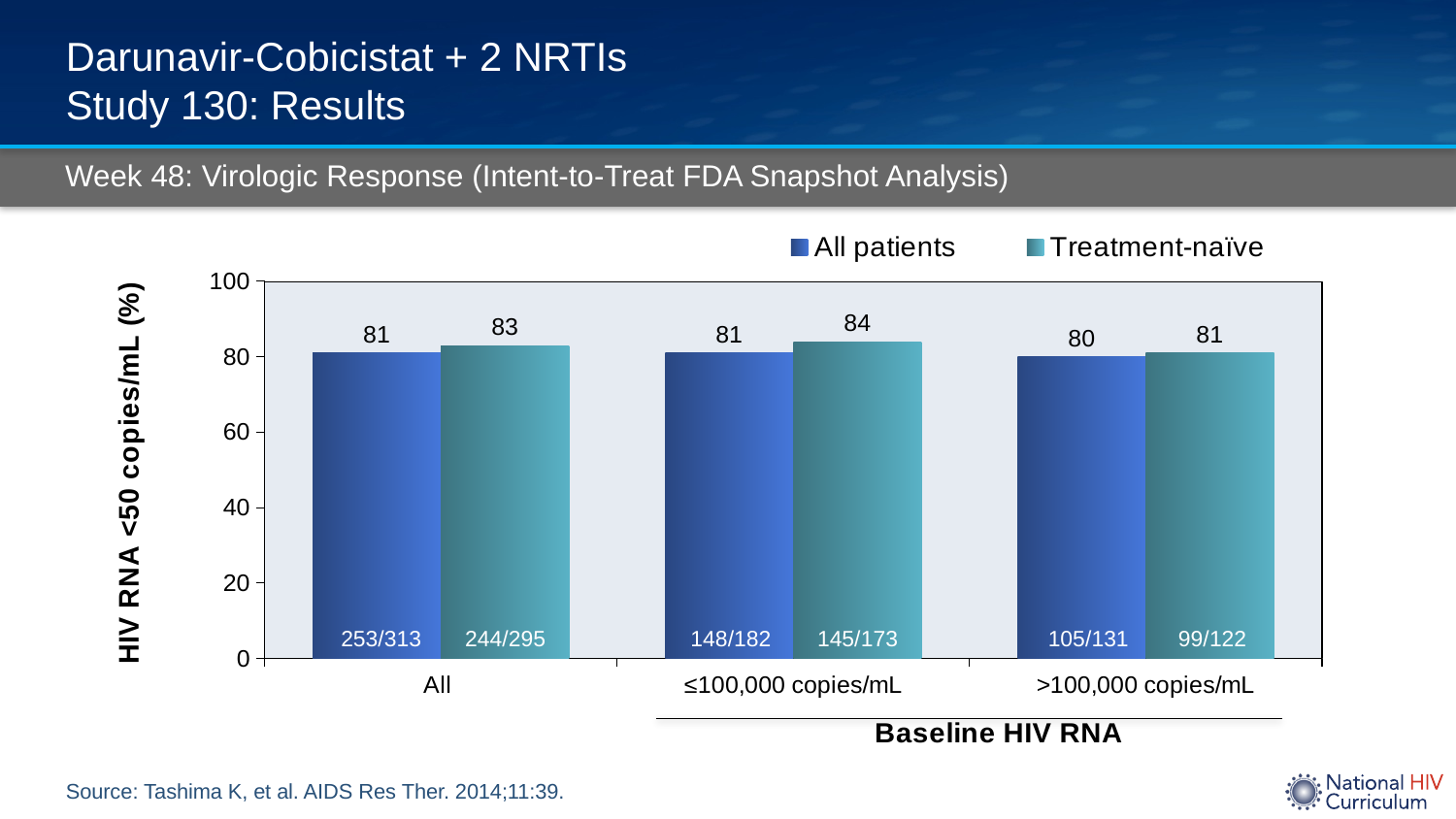
What is the value for All patients in the >100,000 copies/mL category? 80 What fraction is printed inside the All patients bar for the ≤100,000 copies/mL category? 148/182 What fraction is printed inside the Treatment-naïve bar for the >100,000 copies/mL category? 99/122 How many series does the legend list? 2 How many categories are shown on the x axis? 3 What is the difference between the Treatment-naïve and All patients values in the ≤100,000 copies/mL category? 3 What is the value for Treatment-naïve in the ≤100,000 copies/mL category? 84 What is the label of the y axis? HIV RNA <50 copies/mL (%) What is the difference between the Treatment-naïve and All patients values in the All category? 2 What is the value for Treatment-naïve in the All category? 83 What is the value for All patients in the All category? 81 What kind of chart is shown on the slide? Bar chart